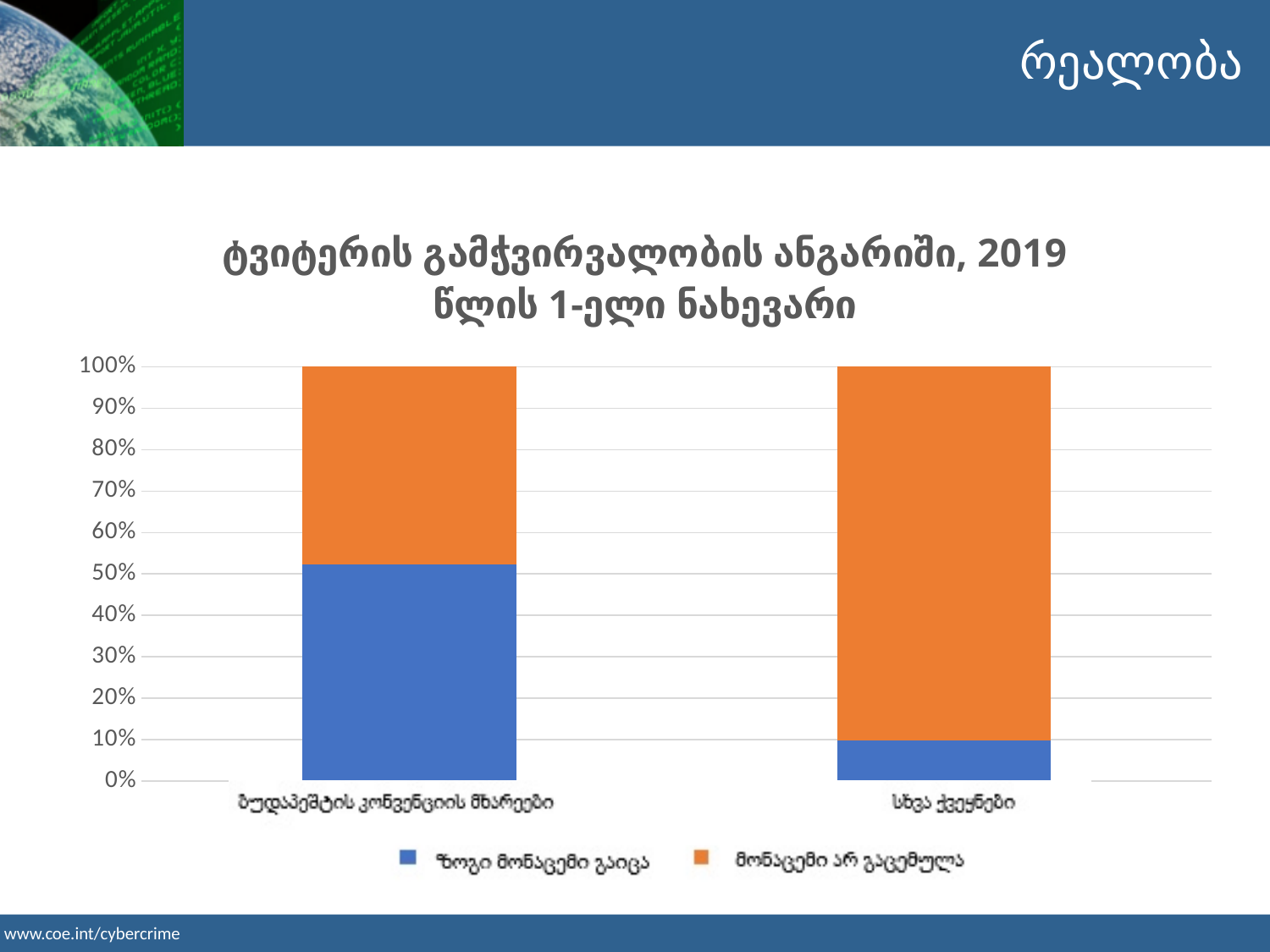
How many categories are shown on the x axis of the chart? 2 Is the "ზოგი მონაცემი გაიცა" share larger for "ბუდაპეშტის კონვენციის მხარეები" or for "სხვა ქვეყნები"? ბუდაპეშტის კონვენციის მხარეები What is the title of the chart? ტვიტერის გამჭვირვალობის ანგარიში, 2019 წლის 1-ელი ნახევარი Which category has the larger share for "მონაცემი არ გაცემულა"? სხვა ქვეყნები How many series does the chart legend list? 2 What kind of chart is shown on the slide? stacked bar chart Which colour represents the series "ზოგი მონაცემი გაიცა" in the chart? blue What is the total height of the stacked bar for "სხვა ქვეყნები"? 100% Is the "ზოგი მონაცემი გაიცა" share for "სხვა ქვეყნები" greater or less than 20%? less Is the "მონაცემი არ გაცემულა" share for "სხვა ქვეყნები" greater or less than 80%? greater Which category has the larger share for "ზოგი მონაცემი გაიცა"? ბუდაპეშტის კონვენციის მხარეები Is the "ზოგი მონაცემი გაიცა" share for "ბუდაპეშტის კონვენციის მხარეები" greater or less than 40%? greater